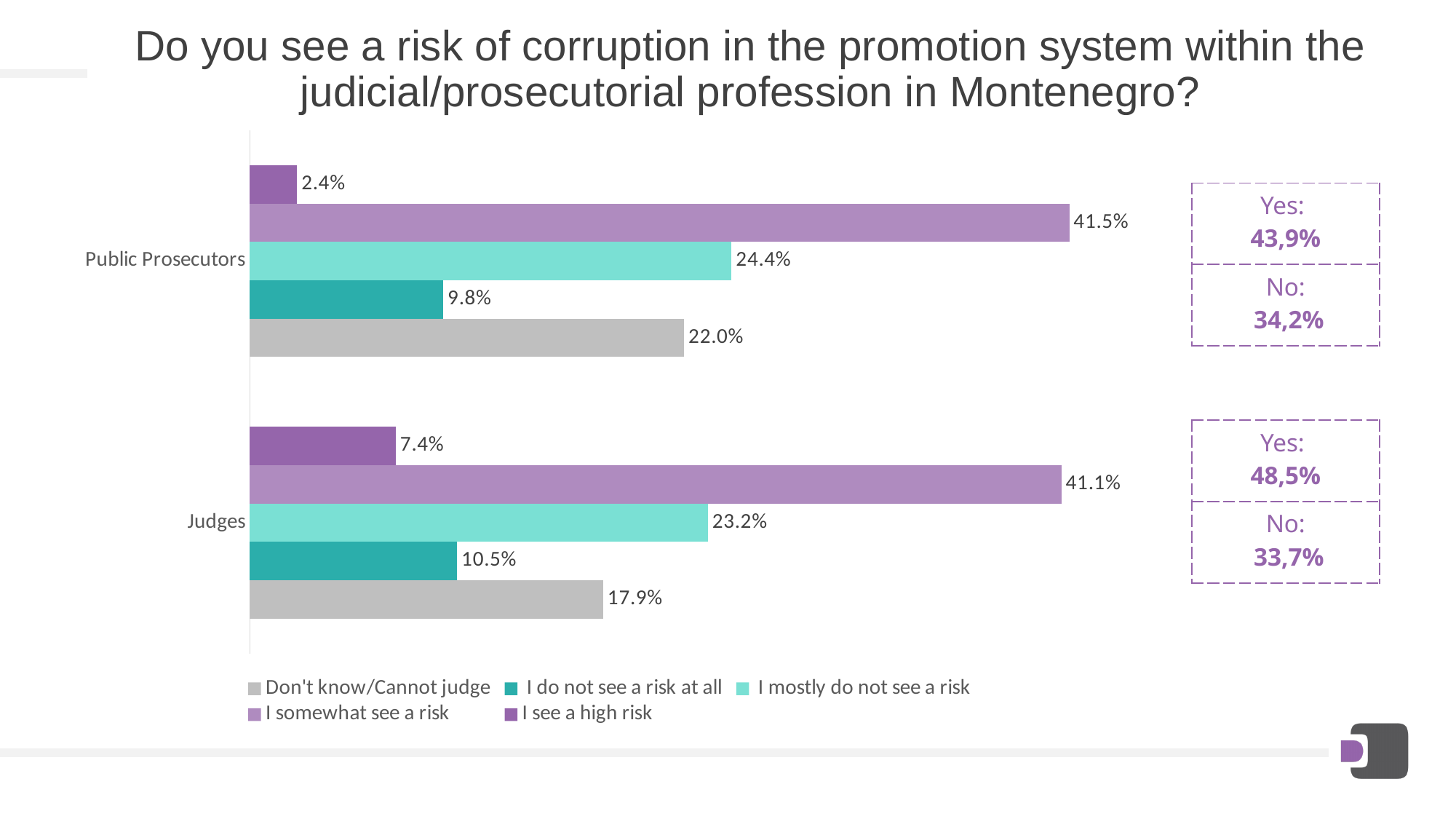
What kind of chart is shown on the slide? Bar chart Which response category has the lowest value among Public Prosecutors? I see a high risk Which group has a higher value for "Don't know/Cannot judge", Public Prosecutors or Judges? Public Prosecutors What percentage of Public Prosecutors answered "I do not see a risk at all"? 9.8% What percentage of Judges answered "Don't know/Cannot judge"? 17.9% Which group has a higher value for "I see a high risk", Public Prosecutors or Judges? Judges Which response category has the highest value among Judges? I somewhat see a risk What percentage of Judges answered "I see a high risk"? 7.4% What percentage of Public Prosecutors answered "I somewhat see a risk"? 41.5% How many series does the legend list? 5 What is the combined "Yes" percentage shown in the box for Judges? 48,5% What is the difference between the "I mostly do not see a risk" values for Public Prosecutors and Judges? 1.2%